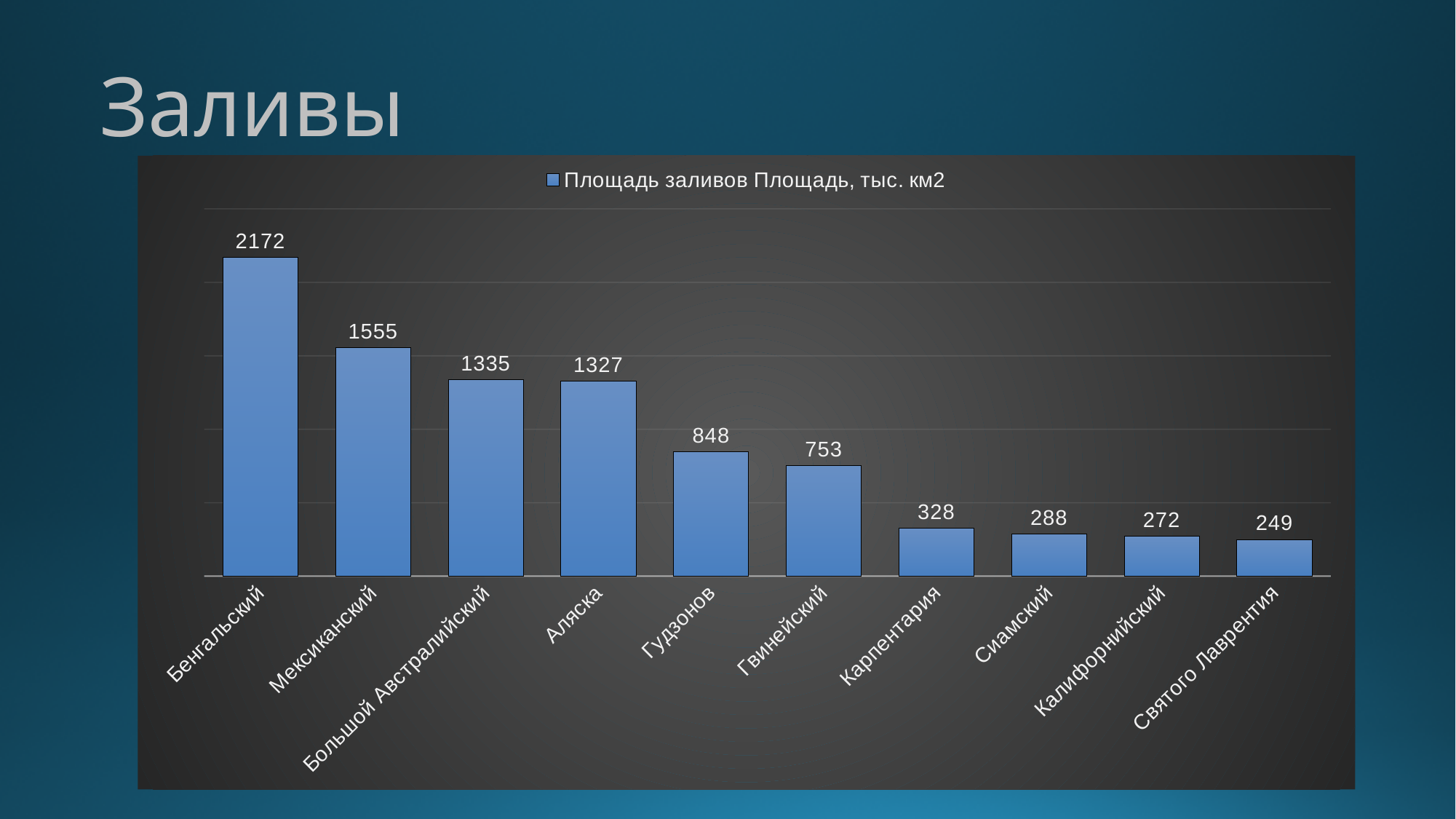
Which category has the highest value? Бенгальский How many series does the legend list? 1 How many categories are shown in the chart? 10 What is the value for Бенгальский? 2172 Do the values rise or fall from left to right along the x axis? fall What is the value for Гудзонов? 848 Which is larger, the value for Карпентария or the value for Сиамский? Карпентария What is the difference between the values for Гудзонов and Гвинейский? 95 What is the value for Святого Лаврентия? 249 What kind of chart is shown on the slide? bar chart What is the difference between the values for Бенгальский and Мексиканский? 617 Which category has the lowest value? Святого Лаврентия